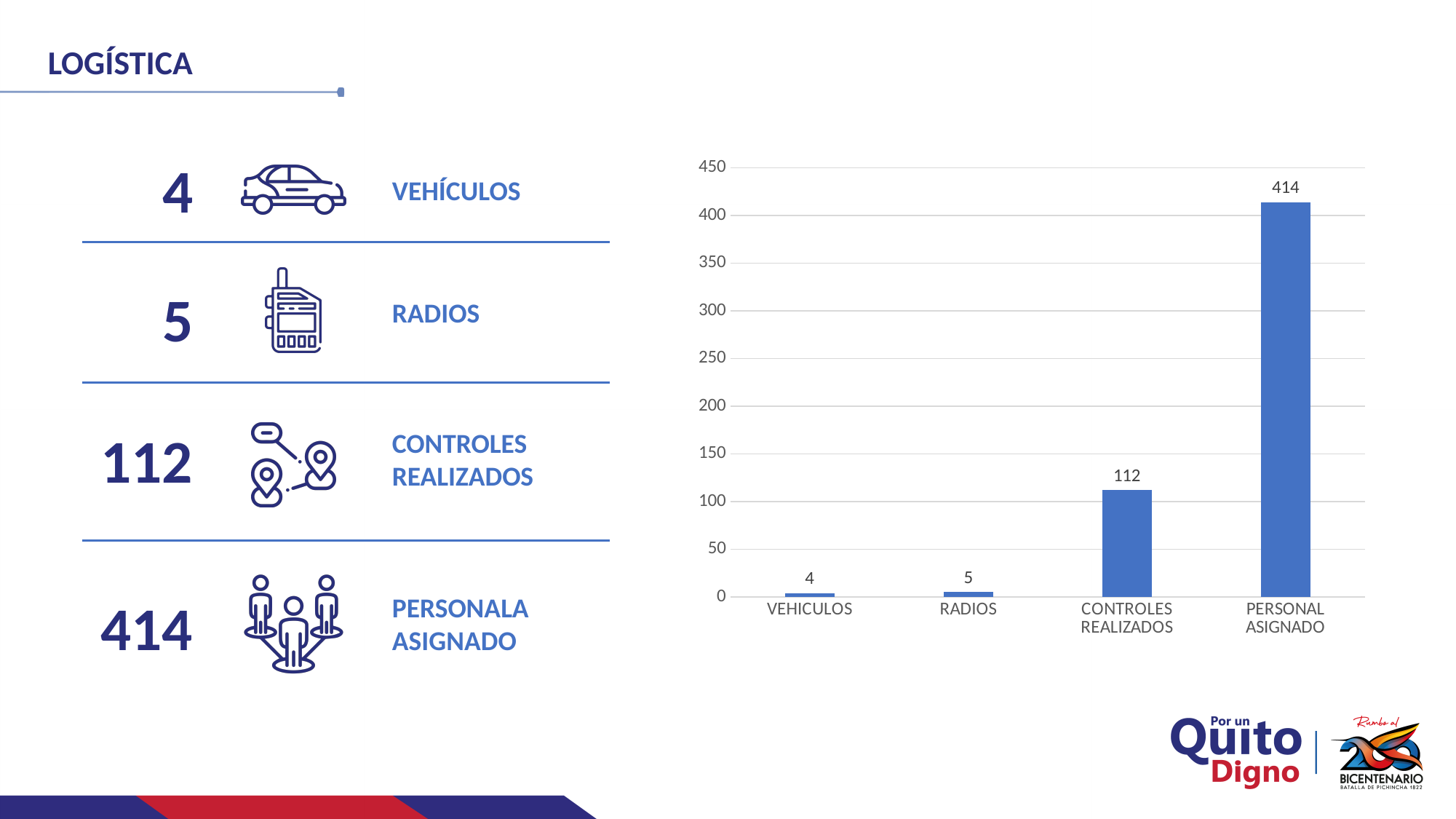
Is the value for PERSONAL ASIGNADO greater or less than 400? greater How many categories are shown on the x axis of the chart? 4 What is the difference between the values for RADIOS and VEHICULOS? 1 What kind of chart is shown on the slide? bar chart What is the value for PERSONAL ASIGNADO in the chart? 414 What is the value for VEHICULOS in the chart? 4 Which is larger, the value for CONTROLES REALIZADOS or the value for RADIOS? CONTROLES REALIZADOS Which category has the lowest value in the chart? VEHICULOS What is the value for CONTROLES REALIZADOS in the chart? 112 What is the value for RADIOS in the chart? 5 Which category has the highest value in the chart? PERSONAL ASIGNADO What is the difference between the values for PERSONAL ASIGNADO and CONTROLES REALIZADOS? 302